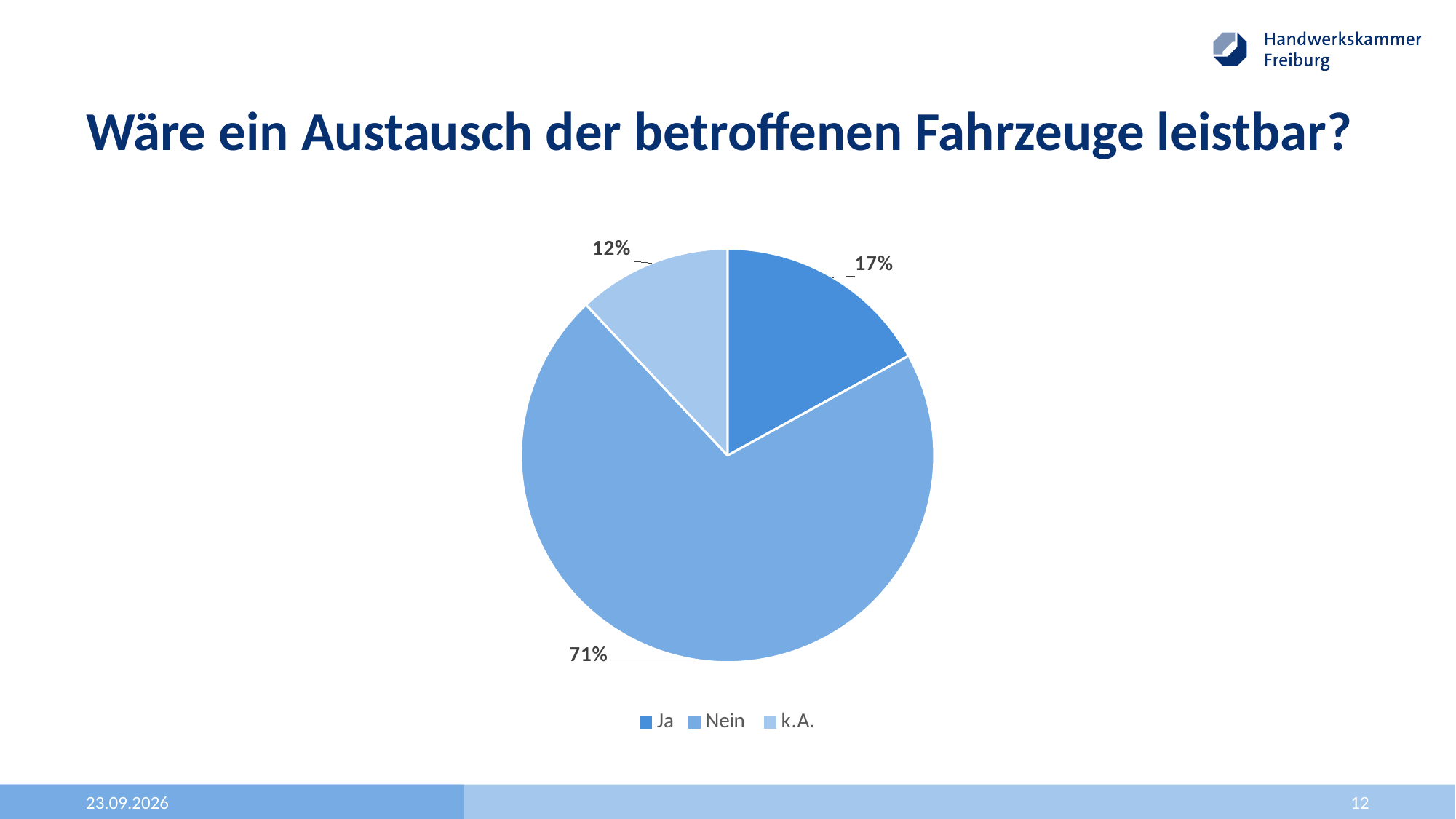
What share of the pie does "Nein" have? 71% What is the difference in percentage points between "Ja" and "k.A."? 5 What is the difference in percentage points between "Nein" and "Ja"? 54 Which category has the largest slice of the pie? Nein How many slices does the pie chart have? 3 What kind of chart is shown on the slide? pie chart What is the title of the slide containing the pie chart? Wäre ein Austausch der betroffenen Fahrzeuge leistbar? How many entries does the legend list? 3 What share of the pie does "k.A." have? 12% Which is larger, the share for "Ja" or the share for "k.A."? Ja What share of the pie does "Ja" have? 17% Which category has the smallest slice of the pie? k.A.